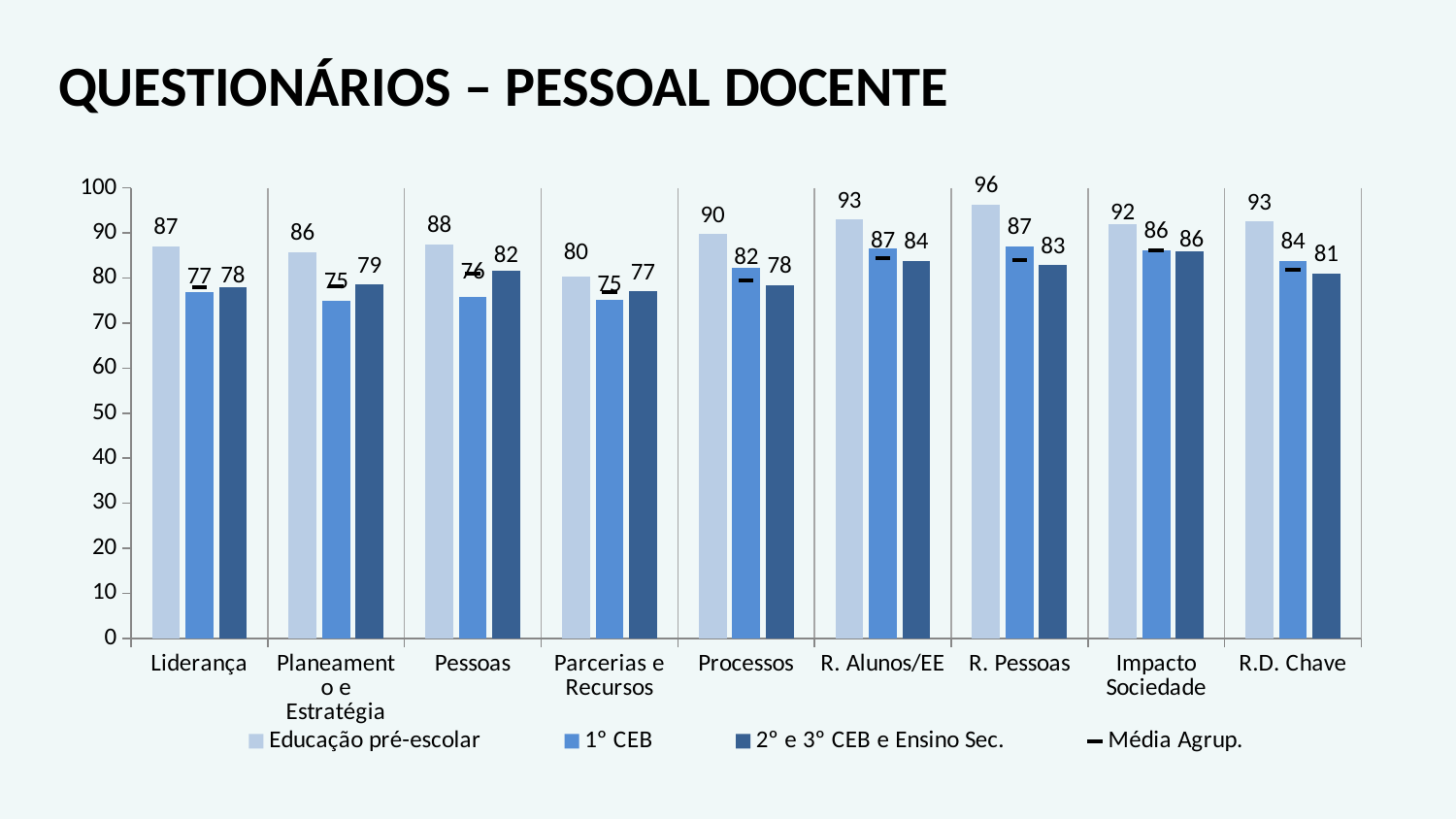
What is the title of the slide? QUESTIONÁRIOS – PESSOAL DOCENTE In which category does Educação pré-escolar reach its highest value? R. Pessoas How many categories are shown on the x axis? 9 What is the value for Educação pré-escolar in the Liderança category? 87 What is the value for 2° e 3° CEB e Ensino Sec. in the R.D. Chave category? 81 How many entries does the legend list? 4 What type of chart is shown on the slide? bar chart In which category does 2° e 3° CEB e Ensino Sec. have its lowest value? Parcerias e Recursos What is the difference between the Educação pré-escolar and 1° CEB values in the Pessoas category? 12 Is the value for 1° CEB in the Parcerias e Recursos category greater or less than 80? less Which is larger in the Processos category: the 1° CEB value or the 2° e 3° CEB e Ensino Sec. value? 1° CEB What is the value for 1° CEB in the Processos category? 82